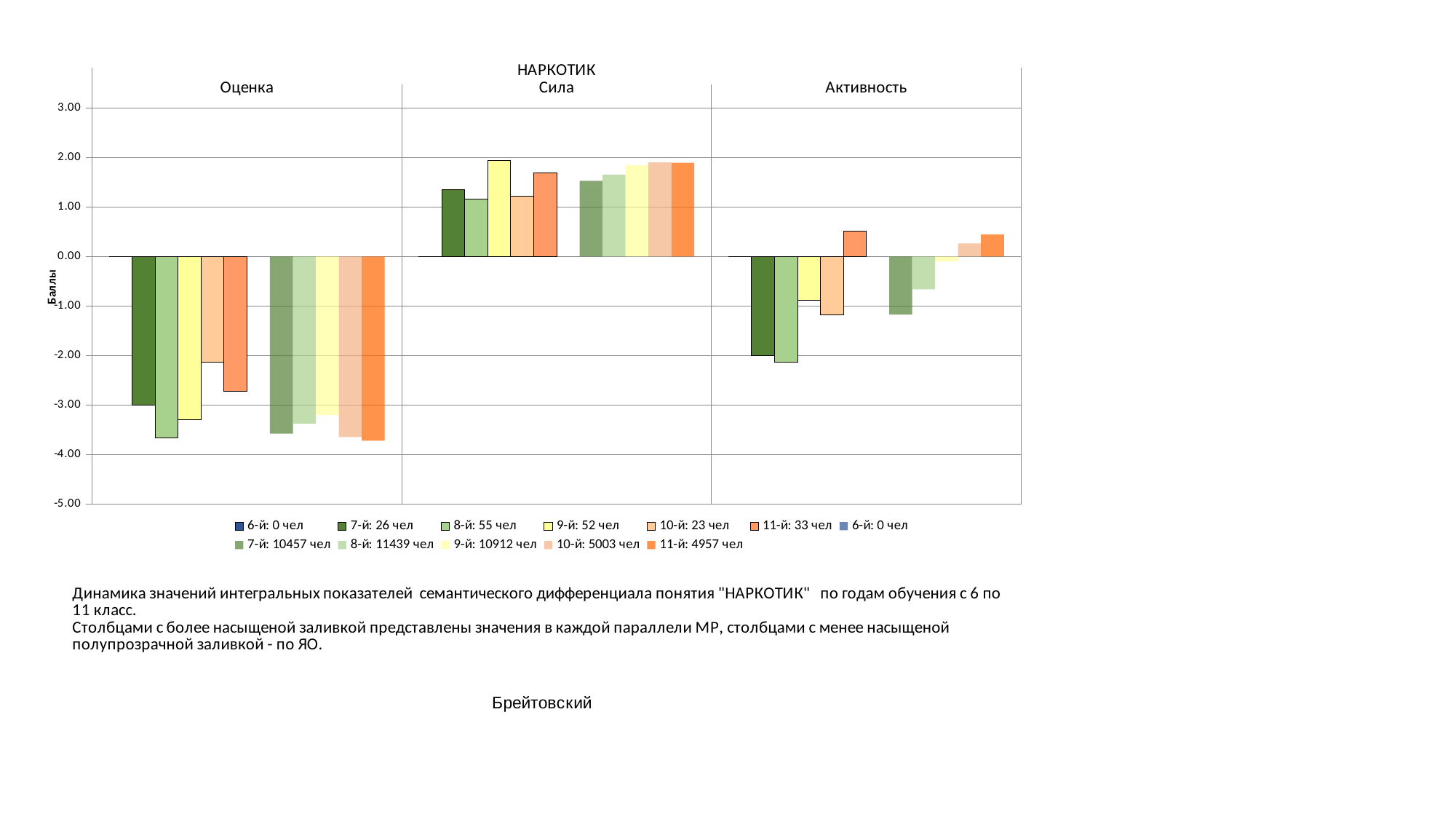
In the Оценка category, which is larger: the value for 10-й: 23 чел or the value for 8-й: 55 чел? 10-й: 23 чел What is the title of the chart? НАРКОТИК In the Сила category, which is larger: the value for 9-й: 52 чел or the value for 8-й: 55 чел? 9-й: 52 чел Is the value for 11-й: 33 чел in the Оценка category greater or less than -3.00? greater Is the value for 8-й: 55 чел in the Активность category greater or less than -1.00? less How many series does the legend list? 12 Is the value for 9-й: 52 чел in the Сила category greater or less than 1.00? greater How many categories are shown along the x axis? 3 What is the label of the vertical axis? Баллы What type of chart is shown on the slide? bar chart